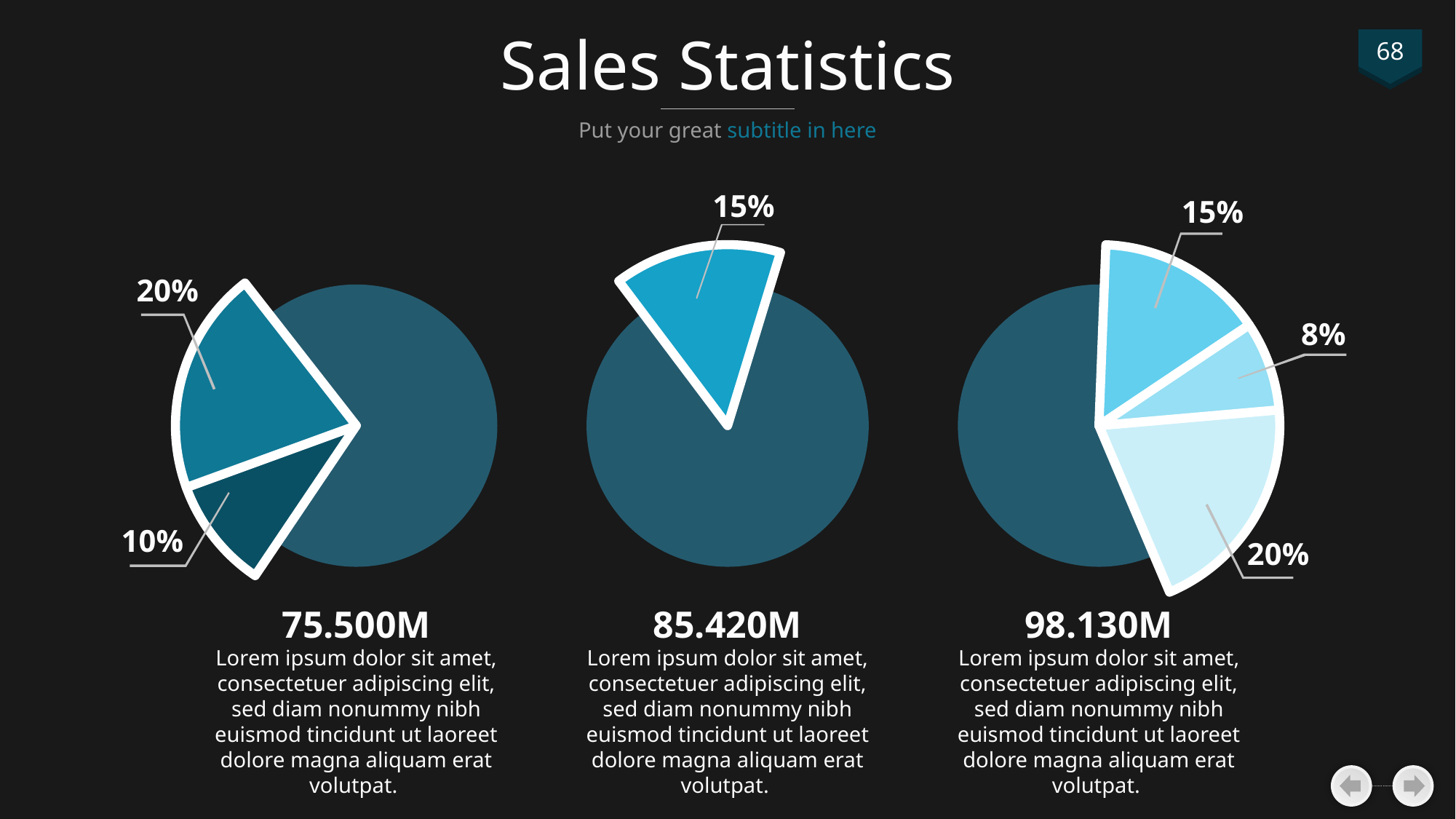
In the left pie chart, what percentage is shown for the larger labelled slice? 20% How many pie charts are on the slide? 3 What figure is printed below the right pie chart? 98.130M In the right pie chart, what is the combined share of the three labelled slices? 43% What figure is printed below the middle pie chart? 85.420M In the middle pie chart, what percentage is shown for the exploded slice? 15% In the left pie chart, what percentage is shown for the smaller labelled slice? 10% In the right pie chart, what is the smallest labelled slice? 8% What type of charts are shown on the slide? pie charts How many labelled slices does the right pie chart have? 3 In the left pie chart, what is the difference between the two labelled slices? 10% In the right pie chart, what is the largest labelled slice? 20%